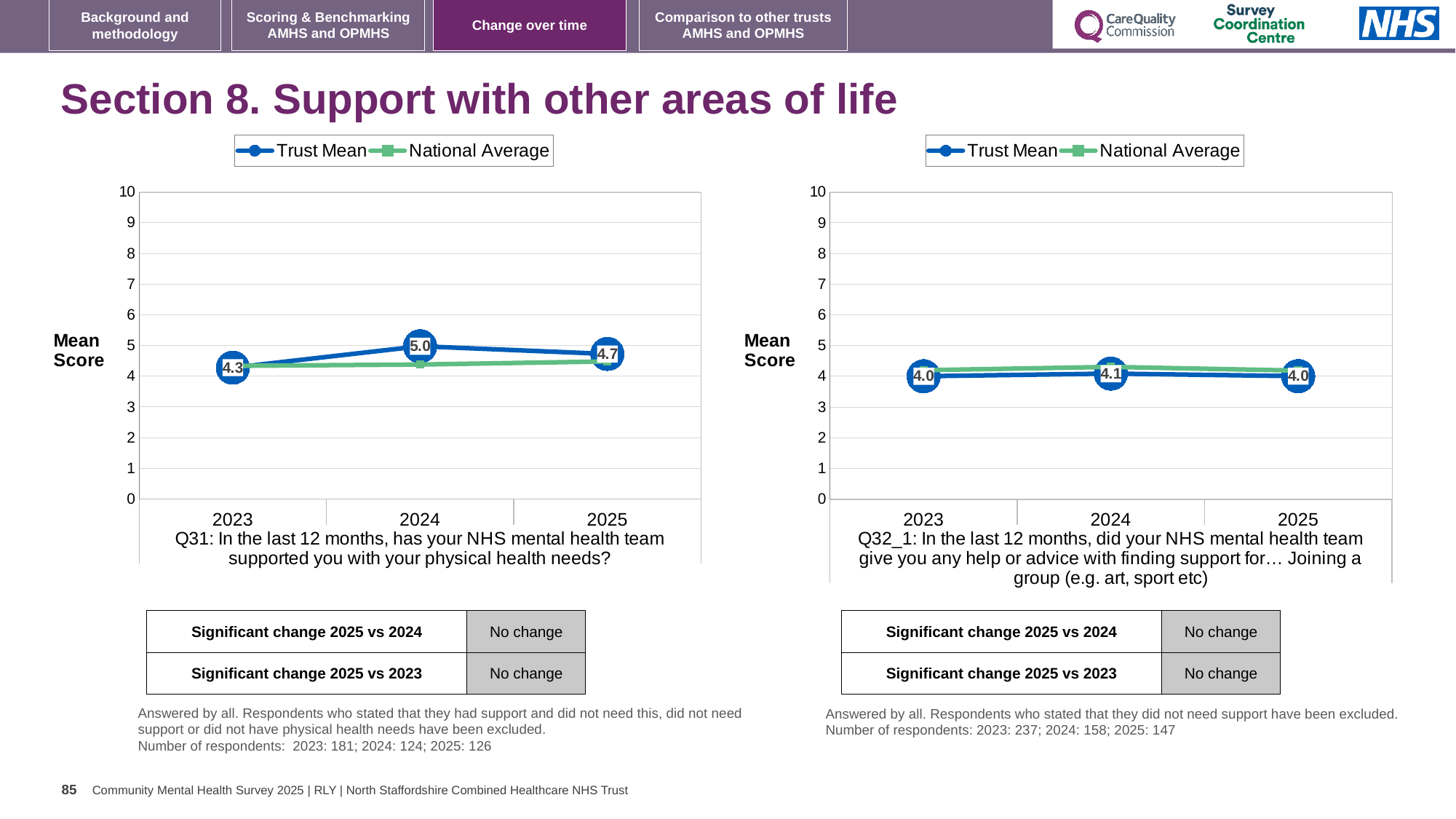
On the left chart (Q31), what is the Trust Mean for 2024? 5.0 On the right chart (Q32_1), how many series does the legend list? 2 On the left chart (Q31), what is the Trust Mean for 2023? 4.3 On the right chart (Q32_1), what is the difference between the Trust Mean for 2024 and 2025? 0.1 On the left chart (Q31), is the Trust Mean larger in 2024 or 2025? 2024 On the left chart (Q31), which year has the lowest Trust Mean? 2023 What kind of chart is the left chart (Q31)? Line chart On the left chart (Q31), what is the difference between the Trust Mean for 2024 and 2023? 0.7 On the right chart (Q32_1), what is the Trust Mean for 2025? 4.0 On the left chart (Q31), how many years are plotted on the x axis? 3 On the right chart (Q32_1), is the National Average for 2024 greater or less than 5? less On the left chart (Q31), which year has the highest Trust Mean? 2024